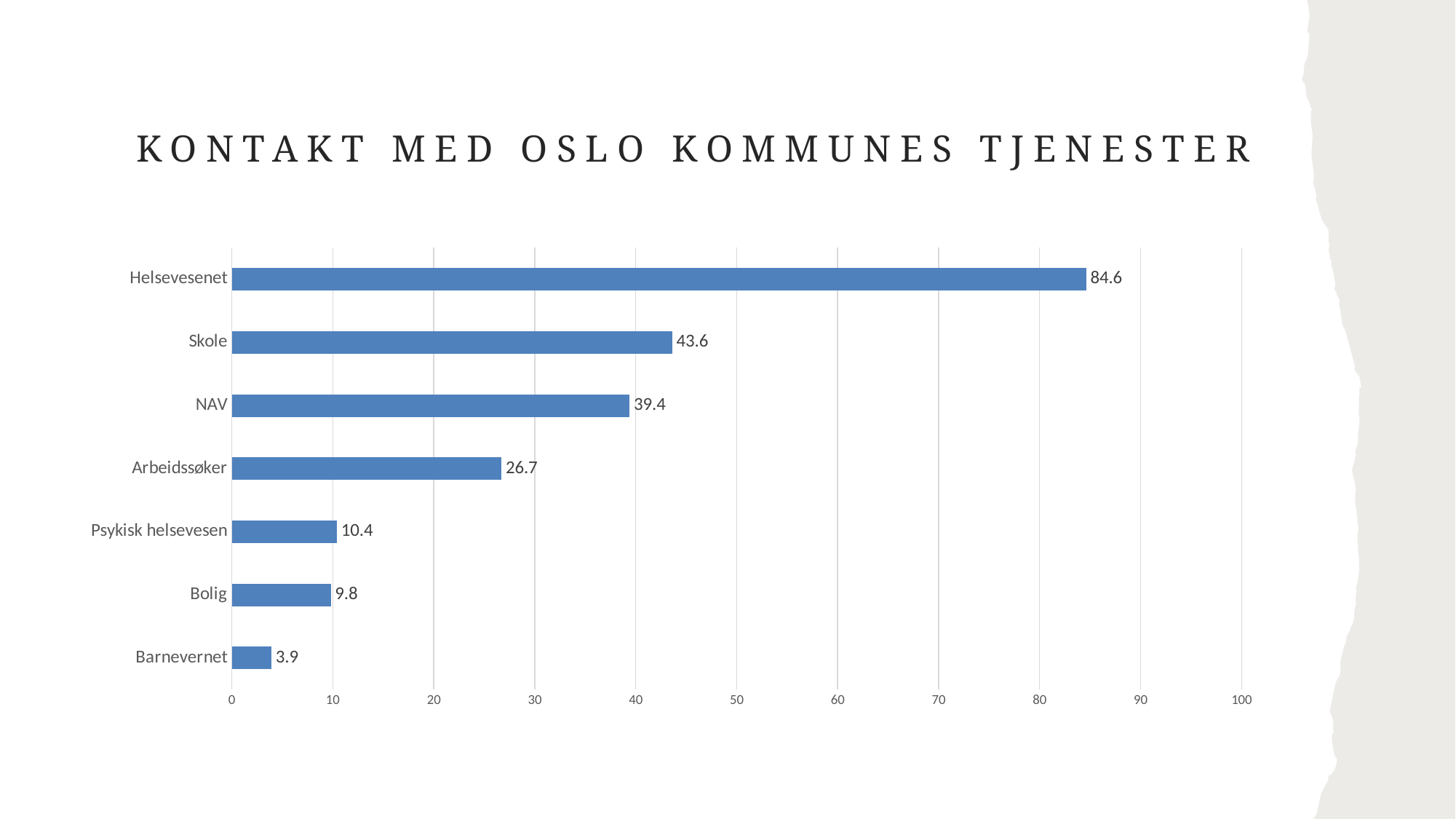
Which is larger, the value for Psykisk helsevesen or the value for Bolig? Psykisk helsevesen What is the difference between the values for Skole and NAV? 4.2 What kind of chart is shown on the slide? bar chart What is the value for NAV? 39.4 Is the value for Arbeidssøker greater or less than 30? less Which category has the highest value? Helsevesenet What is the value for Bolig? 9.8 What is the difference between the values for Helsevesenet and Arbeidssøker? 57.9 How many categories are shown in the chart? 7 Which category has the lowest value? Barnevernet What is the title of the slide? KONTAKT MED OSLO KOMMUNES TJENESTER What is the value for Helsevesenet? 84.6